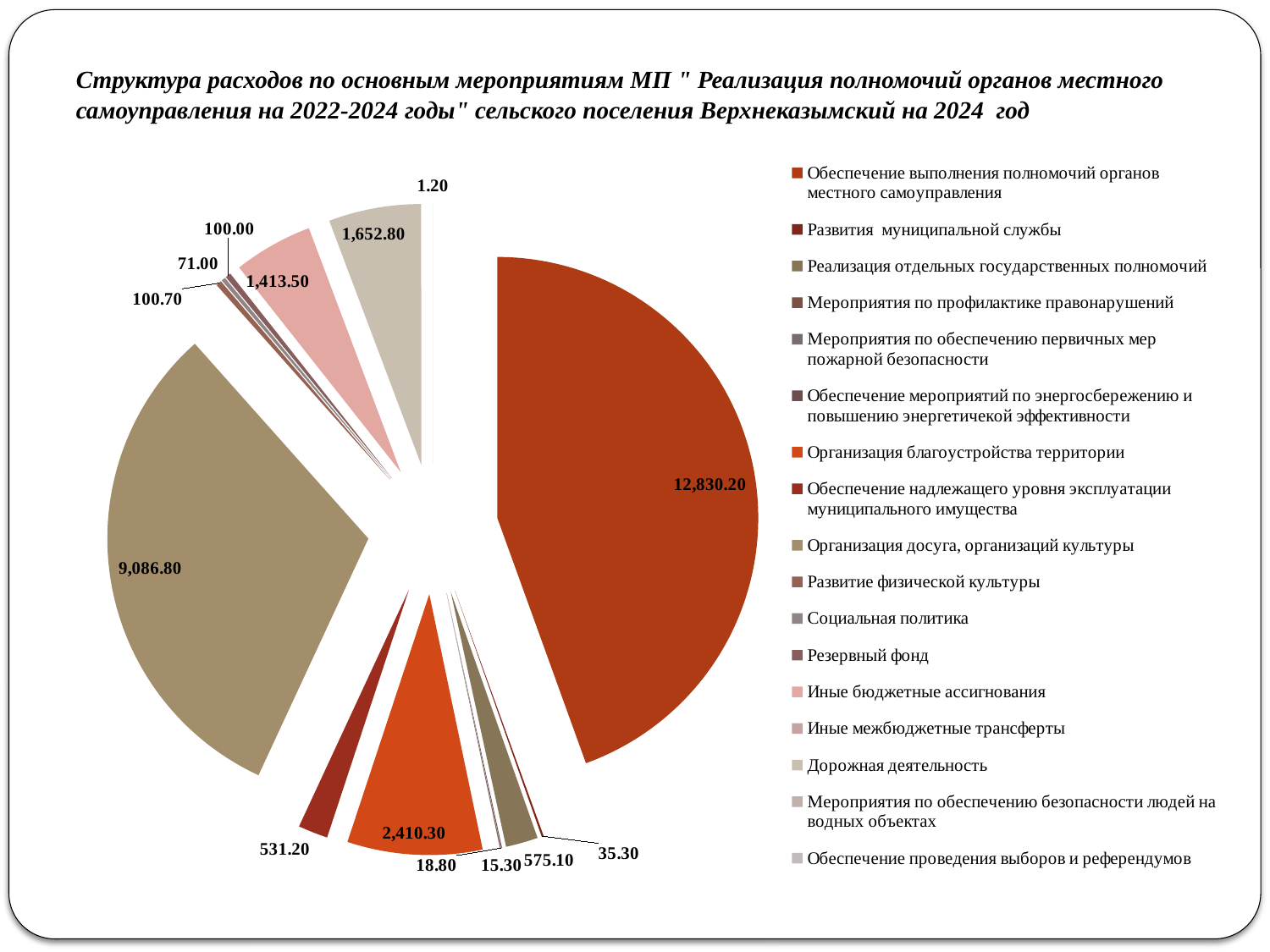
What is the value shown for 'Дорожная деятельность'? 1,652.80 What is the value shown for the largest slice of the pie chart? 12,830.20 What is the value shown for 'Организация благоустройства территории'? 2,410.30 Which category has the largest slice in the pie chart? Обеспечение выполнения полномочий органов местного самоуправления What kind of chart is shown on the slide? Pie chart What is the value shown for 'Обеспечение надлежащего уровня эксплуатации муниципального имущества'? 531.20 What is the smallest value labelled on the pie chart? 1.20 How many entries does the legend of the pie chart list? 17 What is the difference between the values for 'Обеспечение выполнения полномочий органов местного самоуправления' and 'Организация досуга, организаций культуры'? 3,743.40 What is the value shown for 'Иные бюджетные ассигнования'? 1,413.50 Which is larger: the value for 'Дорожная деятельность' or the value for 'Иные бюджетные ассигнования'? Дорожная деятельность What is the value shown for 'Организация досуга, организаций культуры'? 9,086.80